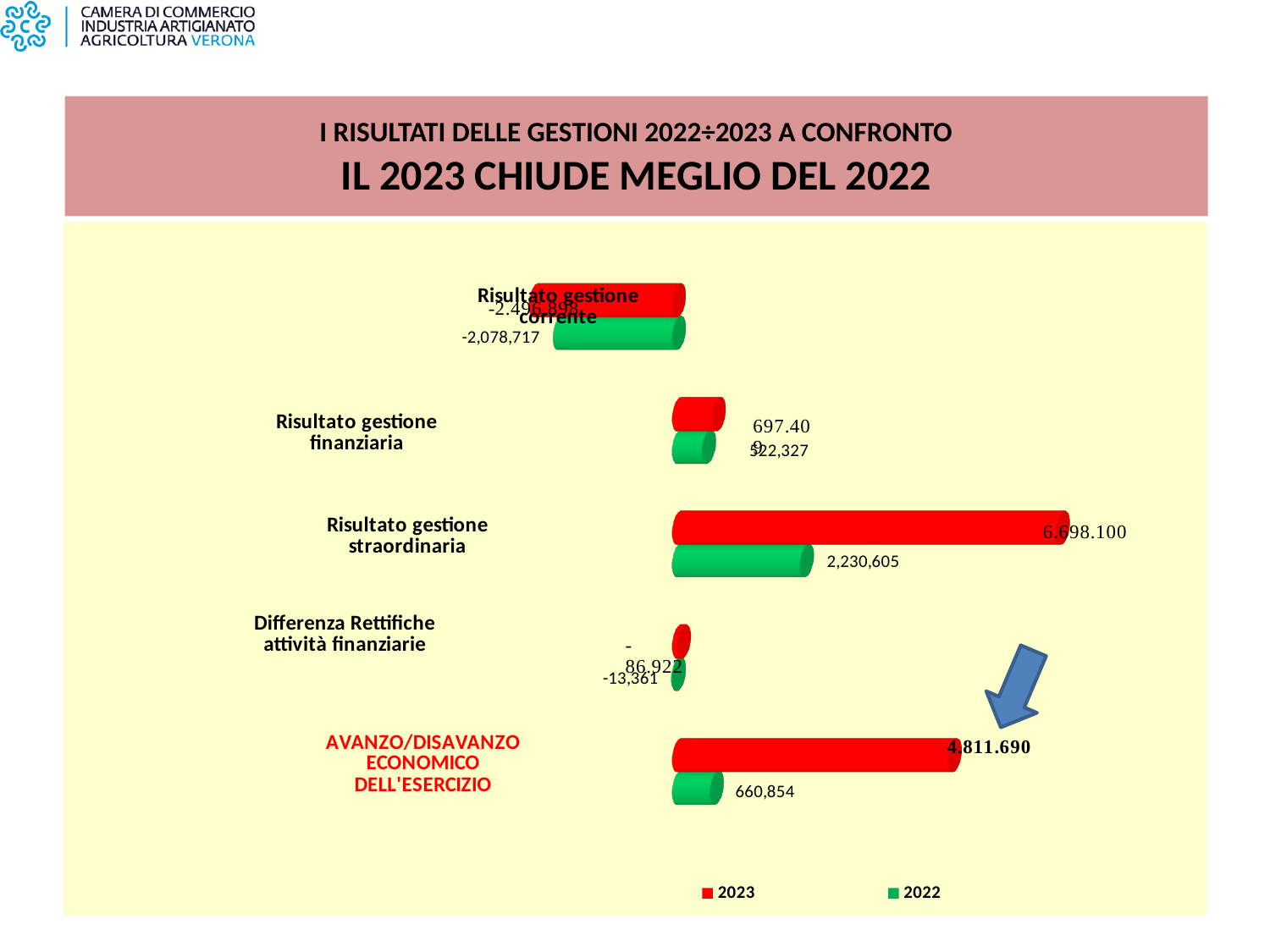
What is the 2022 value for Risultato gestione finanziaria? 522,327 What is the difference between the 2022 values for Risultato gestione straordinaria and AVANZO/DISAVANZO ECONOMICO DELL'ESERCIZIO? 1,569,751 What is the 2023 value for Risultato gestione straordinaria? 6.698.100 What kind of chart is shown on the slide? Bar chart How many series does the legend list? 2 What is the 2022 value for AVANZO/DISAVANZO ECONOMICO DELL'ESERCIZIO? 660,854 What is the 2023 value for AVANZO/DISAVANZO ECONOMICO DELL'ESERCIZIO? 4.811.690 For Risultato gestione straordinaria, which year has the larger value, 2023 or 2022? 2023 Which category has the highest 2023 value? Risultato gestione straordinaria What is the 2022 value for Risultato gestione straordinaria? 2,230,605 What is the 2022 value for Risultato gestione corrente? -2,078,717 What is the 2022 value for Differenza Rettifiche attività finanziarie? -13,361